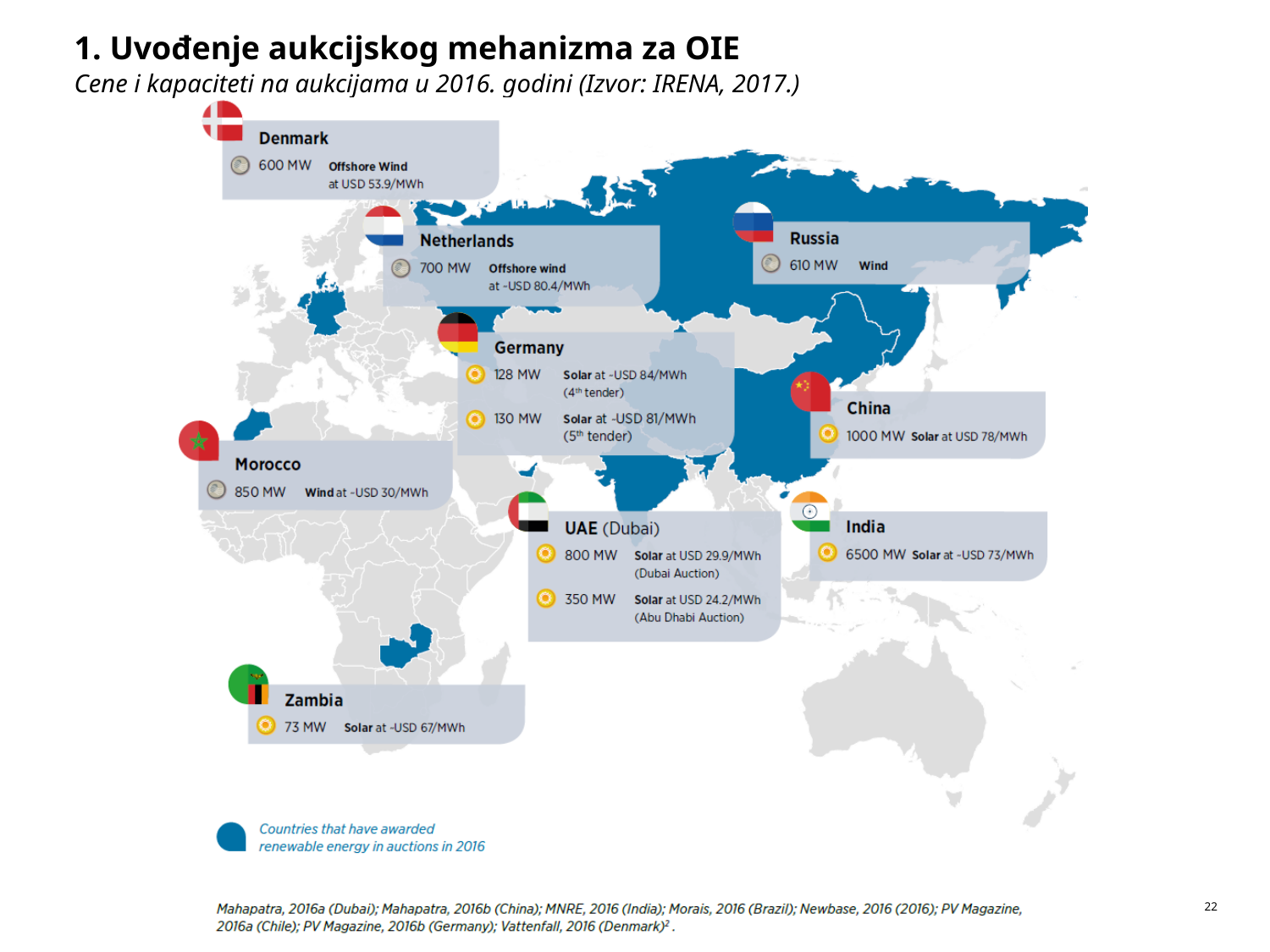
What price per MWh is shown for Denmark's offshore wind? USD 53.9/MWh Which has the larger capacity: the Netherlands offshore wind or Russia's wind? Netherlands What kind of visual is used on this slide to present the auction data? A world map with country callouts What price is shown for the Abu Dhabi Auction solar project under UAE (Dubai)? USD 24.2/MWh Which country shows the smallest auctioned capacity in MW? Zambia According to the legend, what do the blue-shaded countries represent? Countries that have awarded renewable energy in auctions in 2016 What capacity is shown for Morocco, and for which technology? 850 MW, Wind What auctioned capacity is shown for India? 6500 MW How many countries have callout boxes with auction data on the map? 9 What is the combined capacity of the two UAE (Dubai) solar auctions shown? 1150 MW Which country shows the largest auctioned capacity in MW? India What is the difference in MW between China's solar capacity and the UAE Dubai Auction solar capacity? 200 MW